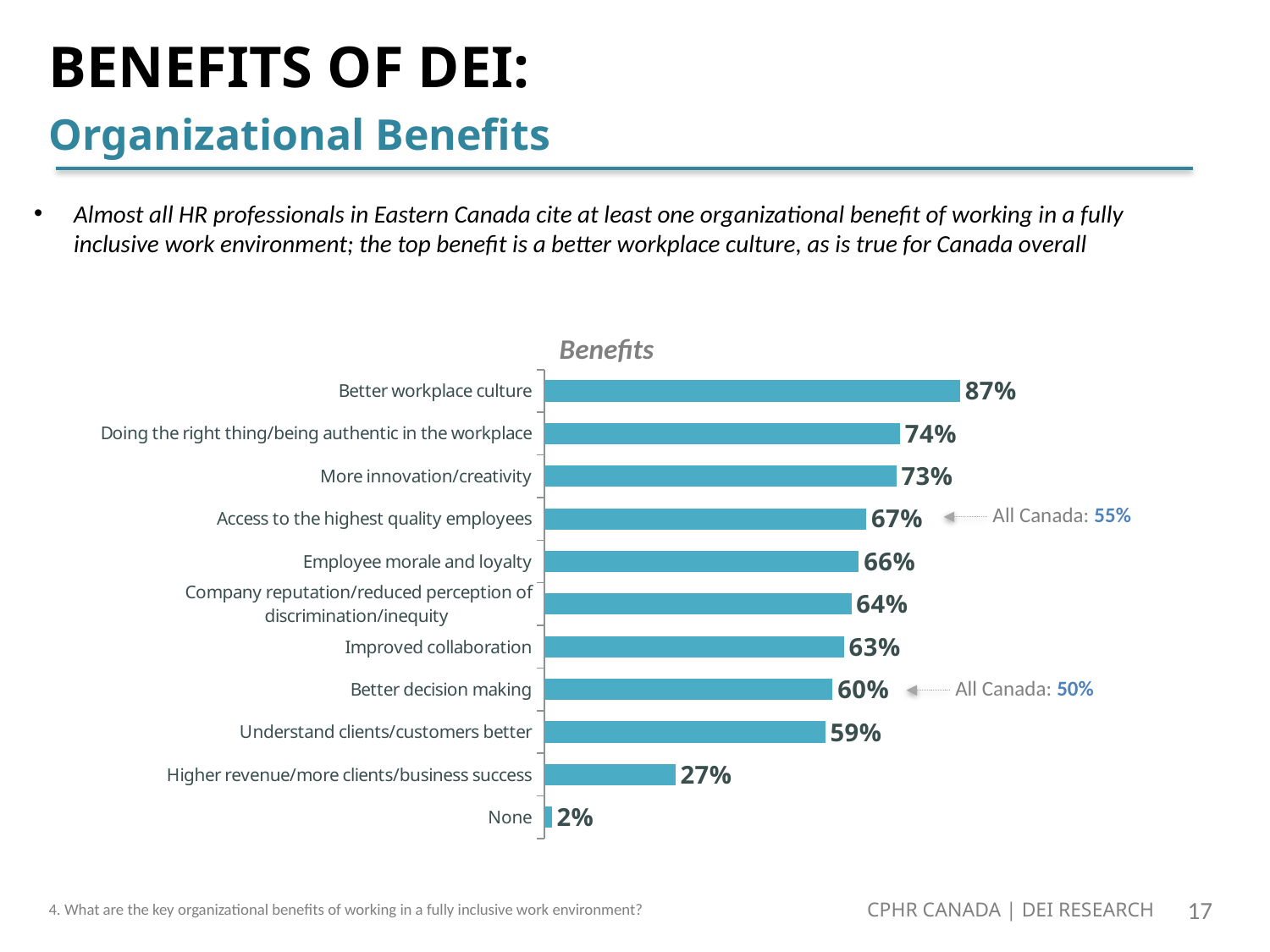
What percentage is shown for Better workplace culture? 87% What is the difference between Better workplace culture and Doing the right thing/being authentic in the workplace? 13% What is the title of the chart? Benefits What is the difference between Understand clients/customers better and Higher revenue/more clients/business success? 32% How many categories are shown in the chart? 11 What percentage is shown for Better decision making? 60% What is the All Canada value noted next to Access to the highest quality employees? 55% Which category has the lowest value? None What type of chart is shown? Bar chart Which category has the highest value? Better workplace culture Which is larger: More innovation/creativity or Employee morale and loyalty? More innovation/creativity What is the value for Higher revenue/more clients/business success? 27%